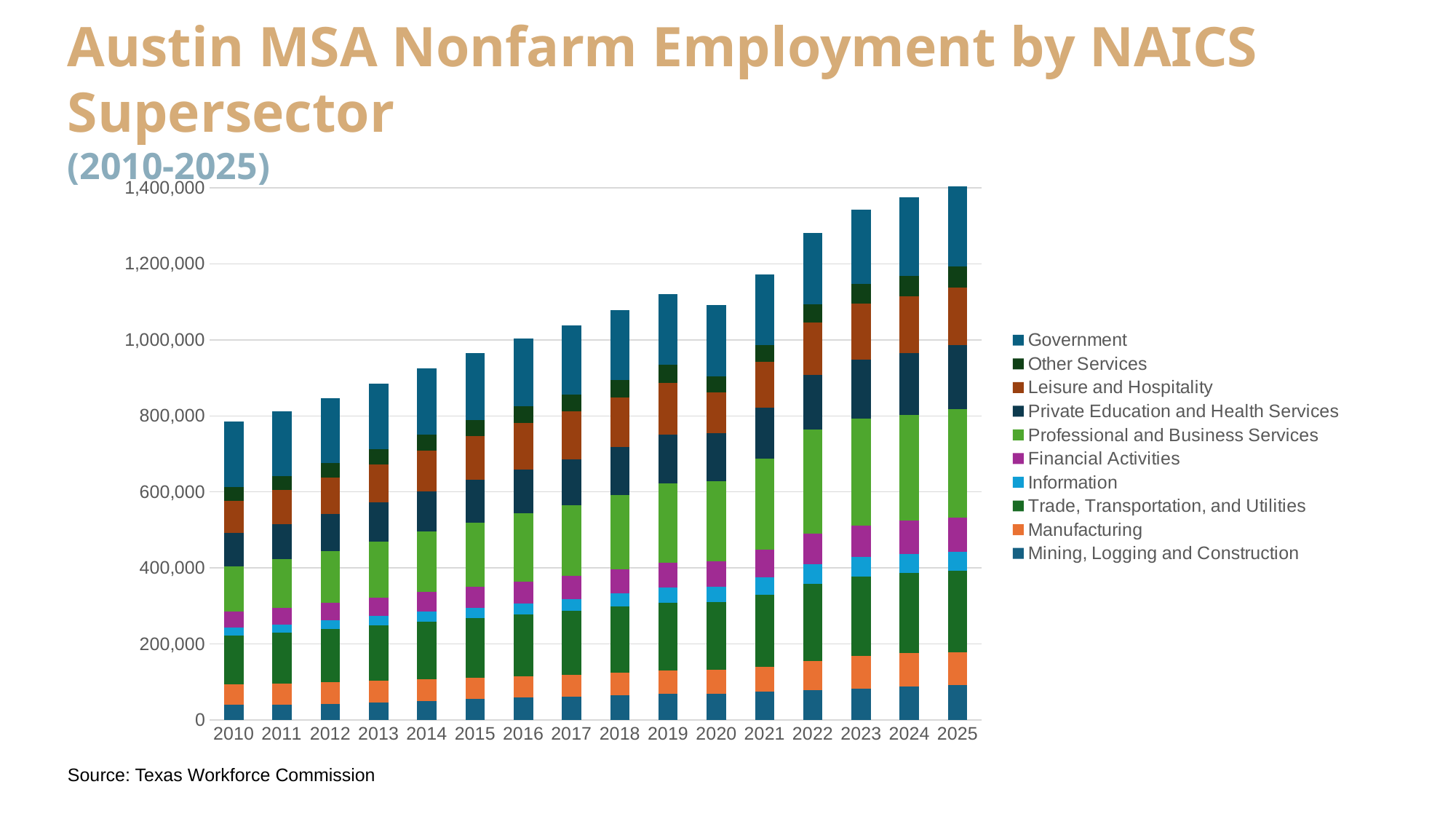
How many years are shown along the x axis of the chart? 16 What kind of chart is shown on the slide? Stacked bar chart Which year has the highest total nonfarm employment? 2025 Is the total employment for 2020 greater or less than 1,000,000? greater Is the total employment for 2015 greater or less than 1,000,000? less How many series does the legend list? 10 Which series is listed at the bottom of the legend? Mining, Logging and Construction Is the total employment for 2022 greater or less than 1,200,000? greater Which year has the lowest total nonfarm employment? 2010 What is the source cited for the chart data? Texas Workforce Commission Which year has a larger total employment, 2021 or 2020? 2021 Do total employment values generally rise or fall from 2010 to 2025? rise